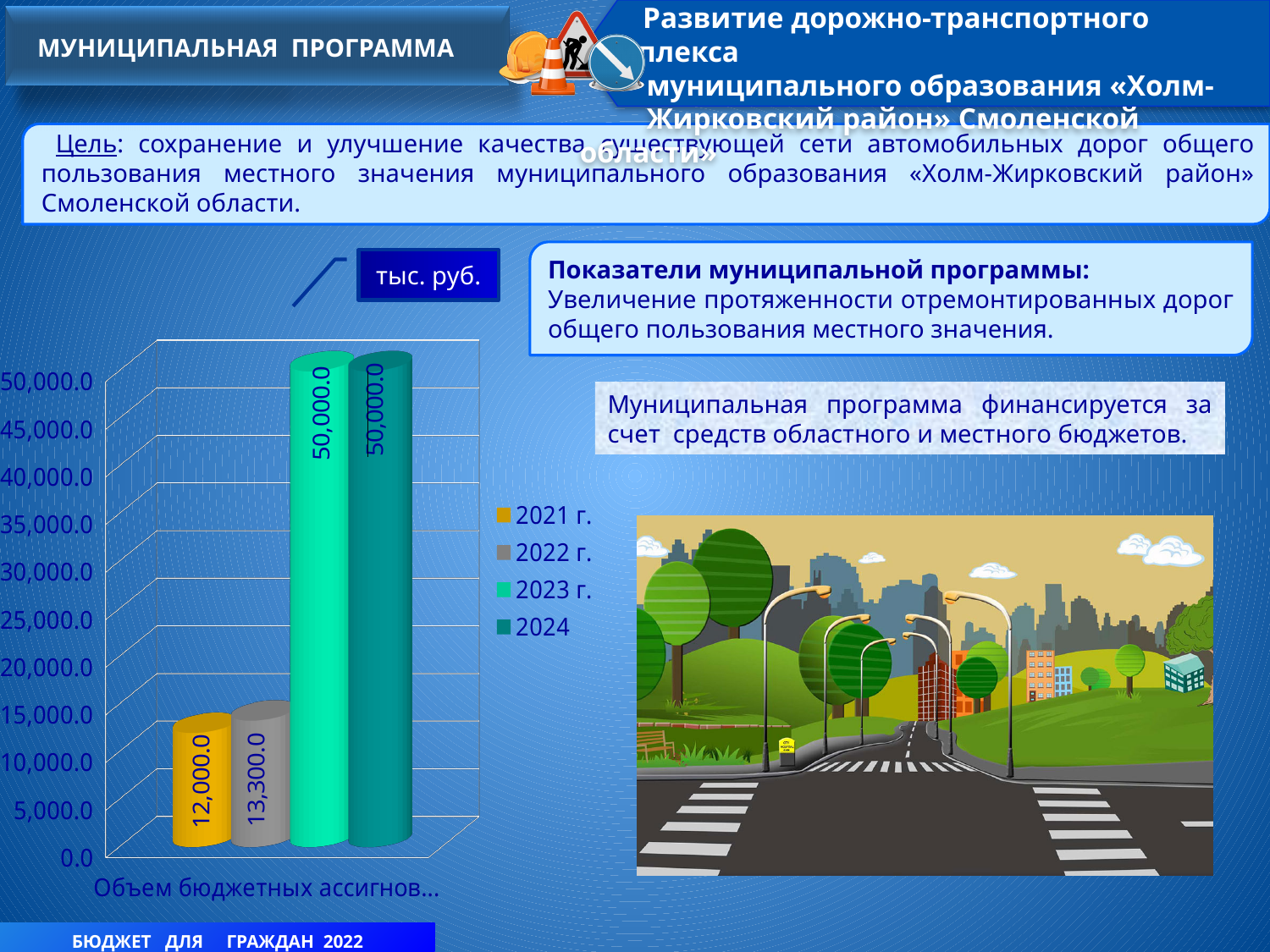
What kind of chart is shown on the slide? bar chart What is the value for the 2021 г. series in the chart? 12,000.0 What is the value for the 2024 series in the chart? 50,000.0 What is the value for the 2023 г. series in the chart? 50,000.0 Which is larger in the chart, the value for 2022 г. or the value for 2021 г.? 2022 г. What is the difference between the 2023 г. and 2022 г. values in the chart? 36,700.0 Which series has the lowest value in the chart? 2021 г. How many series does the chart legend list? 4 Is the value for 2022 г. greater or less than 15,000.0? less What is the value for the 2022 г. series in the chart? 13,300.0 What unit is indicated for the chart values? тыс. руб. What is the difference between the 2022 г. and 2021 г. values in the chart? 1,300.0